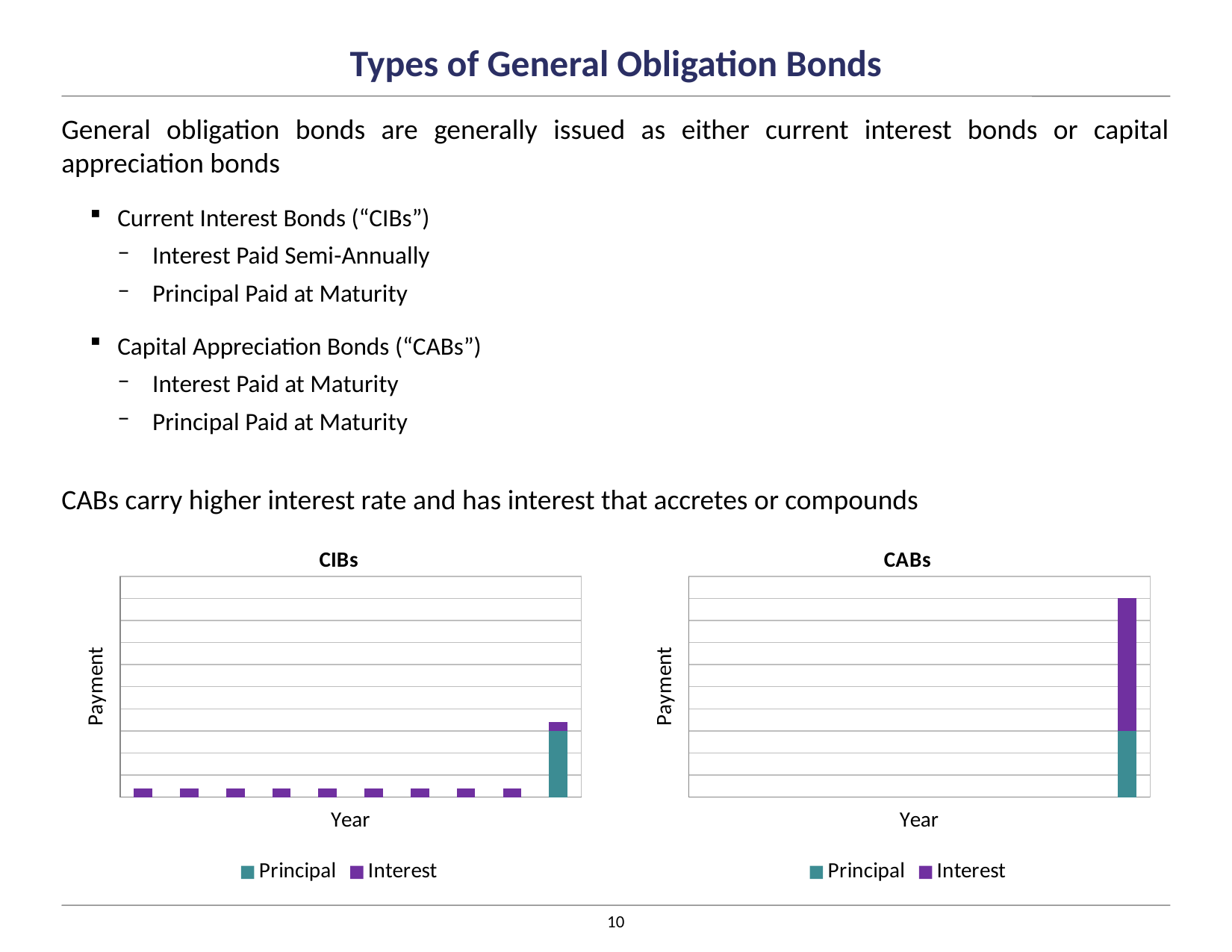
In the CIBs chart, in how many years is Principal paid? 1 In the CABs chart, which series makes up the larger part of the bar, Principal or Interest? Interest What kind of chart is the CIBs chart? bar chart Which chart, CIBs or CABs, has the taller final stacked bar? CABs How many series does the legend of the CABs chart list? 2 What is the label on the vertical axis of the CIBs chart? Payment In the CIBs chart, do the Interest bars rise, fall, or stay flat across the years before the final year? stay flat In the CIBs chart, which series makes up the larger part of the final stacked bar, Principal or Interest? Principal How many bars are plotted in the CIBs chart? 10 How many bars are plotted in the CABs chart? 1 What are the two series named in the legend of the CIBs chart? Principal and Interest